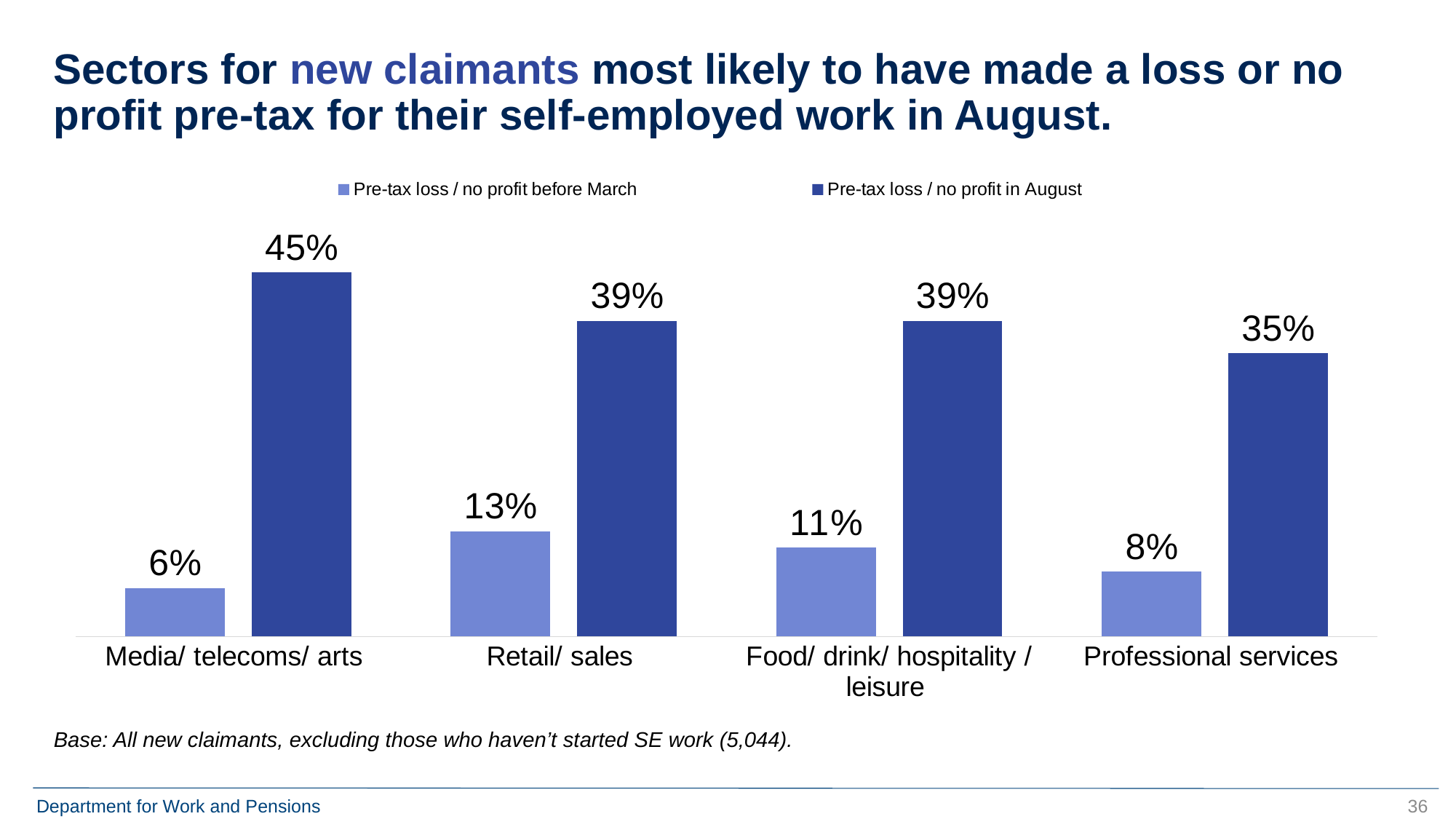
Which sector has the lowest value for 'Pre-tax loss / no profit before March'? Media/ telecoms/ arts Which is larger: the 'before March' value for Retail/ sales or for Food/ drink/ hospitality / leisure? Retail/ sales What is the value for 'Pre-tax loss / no profit in August' for Media/ telecoms/ arts? 45% What is the value for 'Pre-tax loss / no profit before March' for Retail/ sales? 13% What is the difference between the 'in August' and 'before March' values for Media/ telecoms/ arts? 39 percentage points What kind of chart is shown on the slide? Bar chart What is the value for 'Pre-tax loss / no profit before March' for Professional services? 8% What is the difference between the 'in August' values for Retail/ sales and Professional services? 4 percentage points Which sector has the highest value for 'Pre-tax loss / no profit in August'? Media/ telecoms/ arts How many sectors are shown on the chart? 4 How many series does the legend list? 2 What is the value for 'Pre-tax loss / no profit in August' for Food/ drink/ hospitality / leisure? 39%